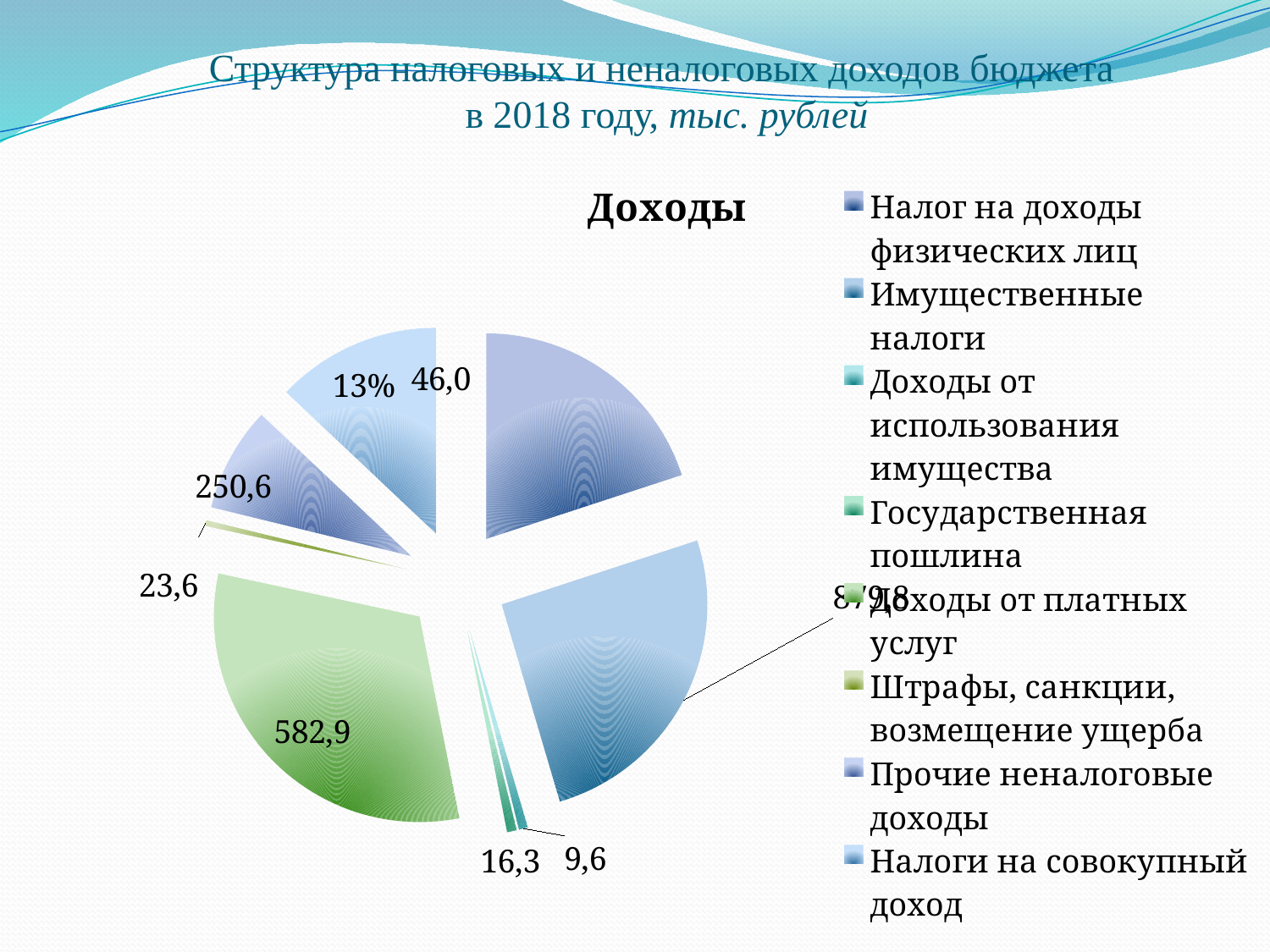
In what units are the values given, according to the slide title? тыс. рублей What is the difference between the slice labelled 582,9 and the slice labelled 250,6? 332,3 What type of chart is shown on the slide? pie chart What is the difference between the slice labelled 16,3 and the slice labelled 9,6? 6,7 What is the value labelled on the largest slice of the pie? 582,9 What percentage label is printed on the pie chart? 13% What is the title of the chart? Доходы How many entries does the chart legend list? 8 What is the difference between the slice labelled 46,0 and the slice labelled 23,6? 22,4